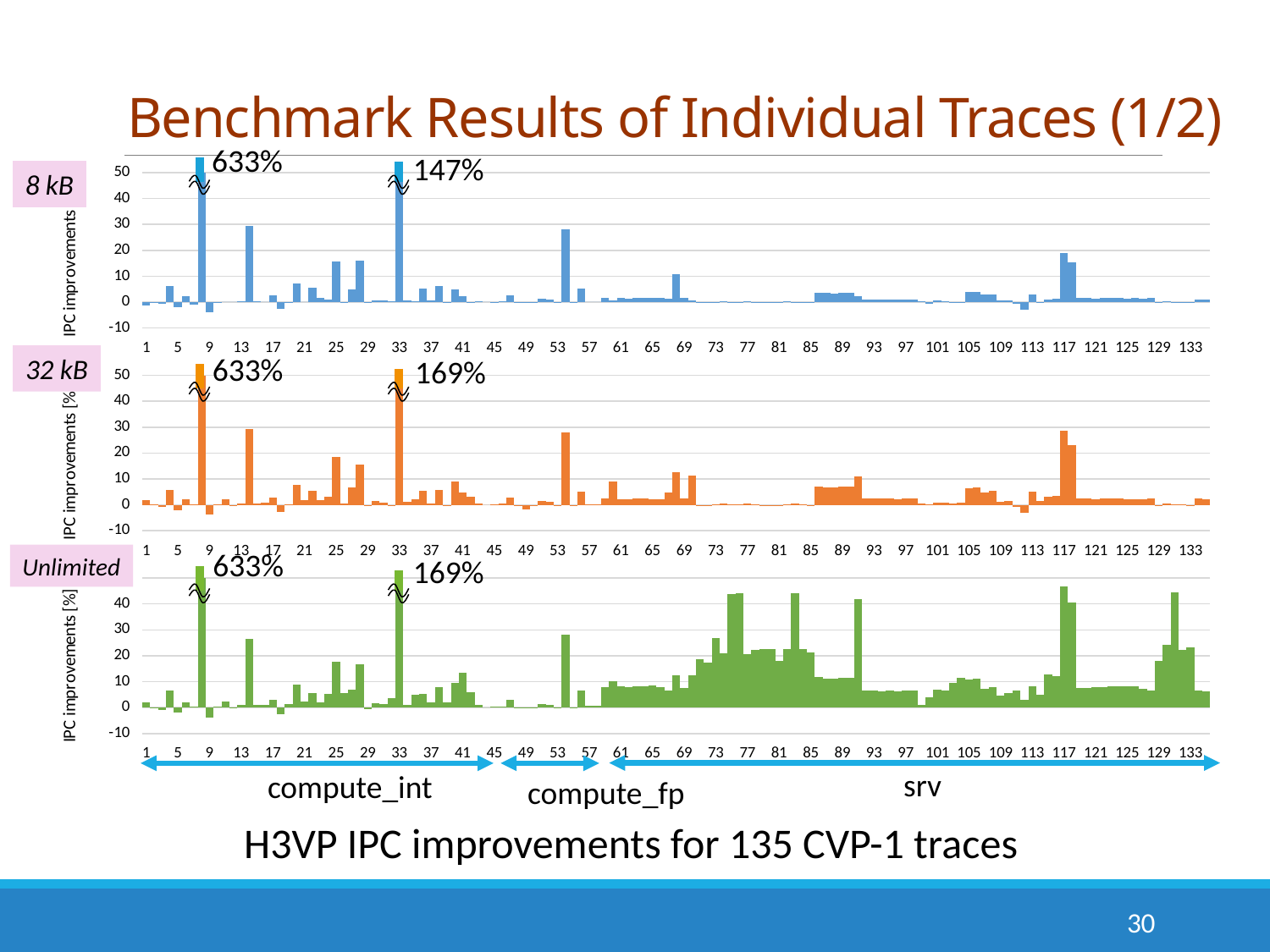
According to the caption, how many CVP-1 traces are plotted? 135 In the 8 kB chart, what value is annotated on the second truncated bar (near trace 33)? 147% In the 32 kB chart, what value is annotated on the truncated bar near trace 33? 169% How many charts (panels) are shown on the slide? 3 How much larger is the annotated value near trace 33 in the 32 kB chart than in the 8 kB chart? 22% What is the y-axis label of the Unlimited chart? IPC improvements [%] What kind of chart is used for the 8 kB panel? bar chart In the 8 kB chart, what value is annotated on the tallest bar? 633% In the Unlimited chart, what value is annotated on the truncated bar near trace 33? 169% In the Unlimited chart, is the value for trace 117 greater or less than 40? greater